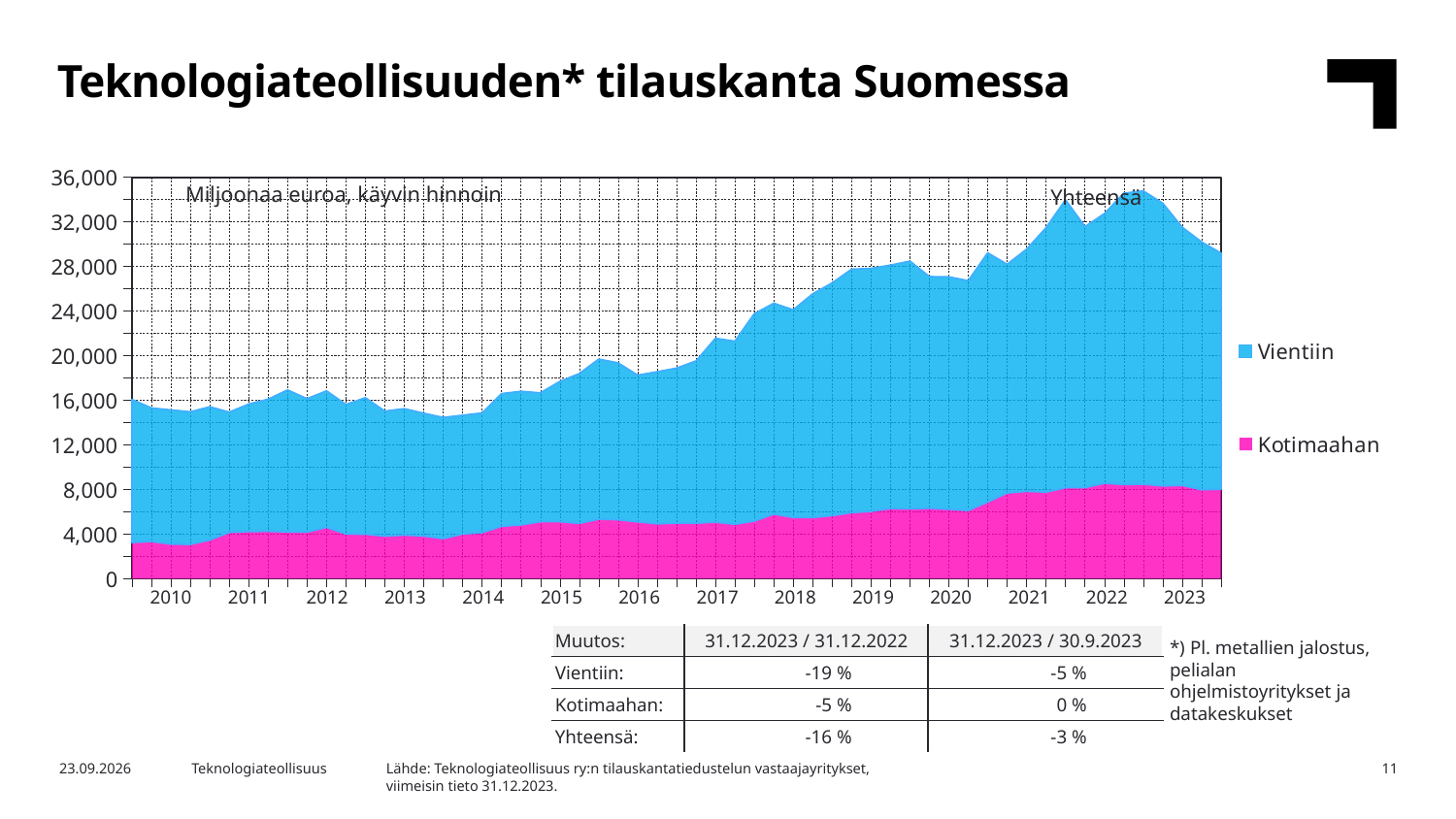
How many years are labelled on the x axis of the chart? 14 How many series does the chart legend list? 2 Which series has the larger values throughout the chart, Vientiin or Kotimaahan? Vientiin Is the Kotimaahan value at the start of 2010 greater or less than 4,000? less Is the total (Yhteensä) value in 2020 greater or less than 24,000? greater Is the total (Yhteensä) order book at its 2022 peak greater or less than 32,000? greater What is the highest value shown on the y axis of the chart? 36,000 Does the total order book generally rise or fall from 2010 to 2022? rise What are the two series named in the chart legend? Vientiin and Kotimaahan What unit is stated for the values in the chart? Miljoonaa euroa, käyvin hinnoin What kind of chart is shown on the slide? Stacked area chart